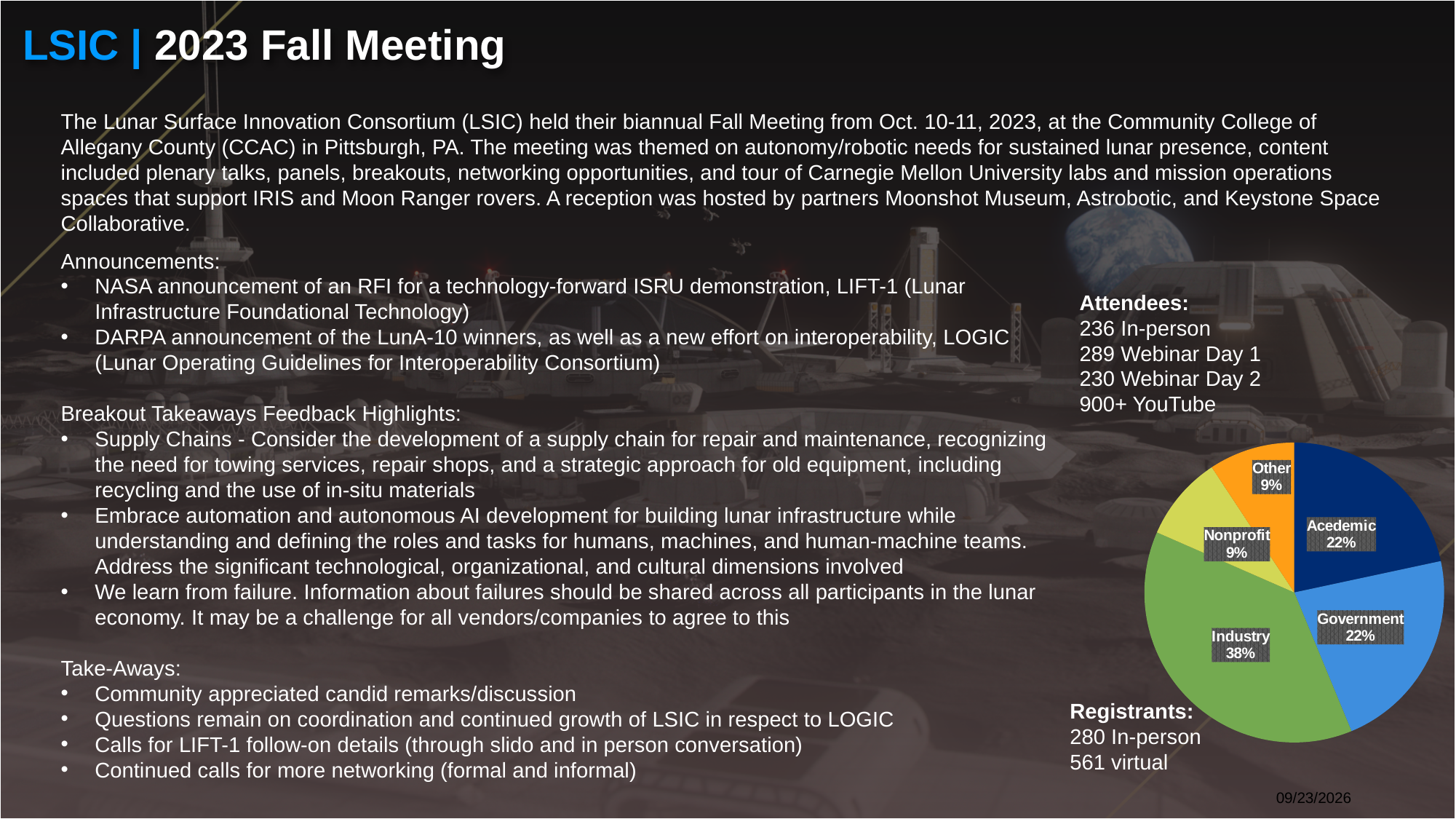
What share of the pie chart is Nonprofit? 9% Which slice of the pie chart is the largest? Industry What share of the pie chart is Other? 9% What is the difference in percentage points between the Industry and Academic slices? 16 How many slices does the pie chart have? 5 What share of the pie chart is the Academic slice? 22% What colour is the Industry slice of the pie chart? Green Which is larger in the pie chart, Industry or Government? Industry What is the combined share of the Academic and Government slices? 44% What share of the pie chart is Industry? 38% What kind of chart is shown on the slide? Pie chart What share of the pie chart is Government? 22%